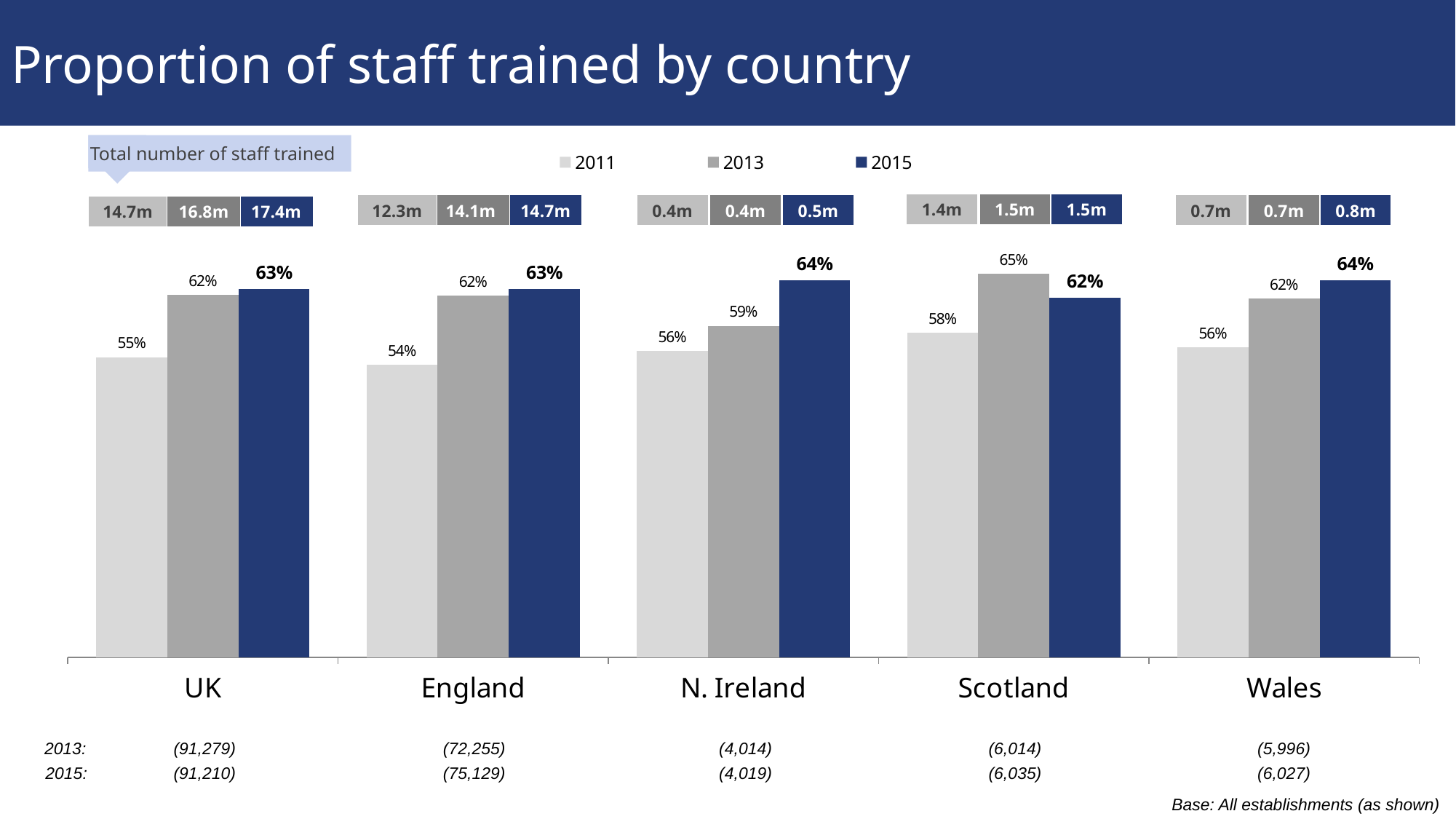
What was the total number of staff trained in the UK in 2015? 17.4m What kind of chart is shown on the slide? Bar chart What proportion of staff were trained in England in 2011? 54% How many countries are shown on the x axis? 5 How many series does the legend list? 3 Did the proportion of staff trained in Wales rise or fall from 2011 to 2015? Rise Which country had the lowest proportion of staff trained in 2011? England Which is larger for Scotland: the 2013 value or the 2015 value? 2013 What proportion of staff were trained in N. Ireland in 2015? 64% Which country had the highest proportion of staff trained in 2013? Scotland What is the difference in percentage points between the 2015 and 2011 values for the UK? 8 What proportion of staff were trained in Scotland in 2013? 65%